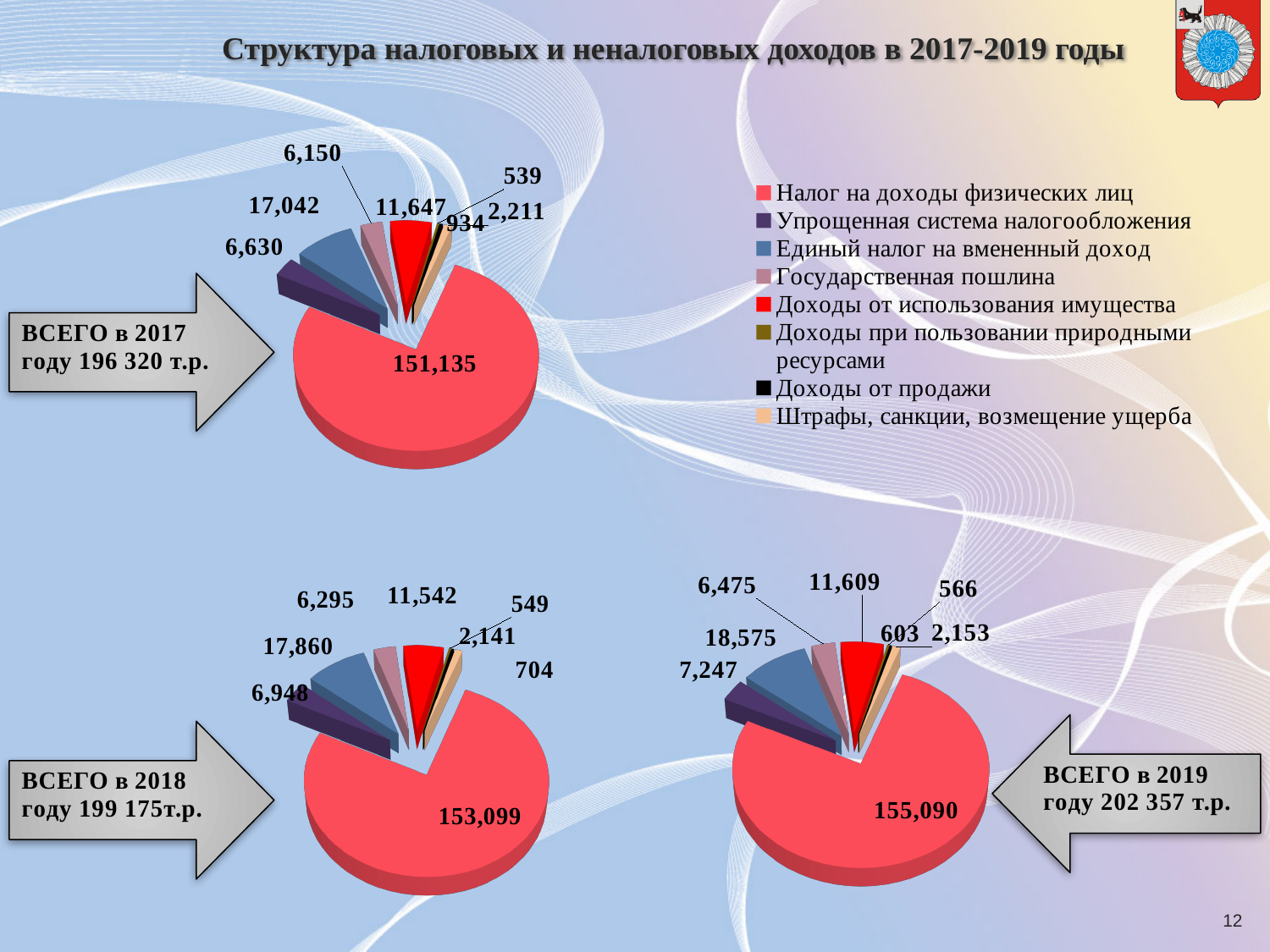
In the 2019 pie chart, what is the value for Доходы от использования имущества? 11,609 In the 2019 pie chart, which is larger: Государственная пошлина or Упрощенная система налогообложения? Упрощенная система налогообложения In the 2019 pie chart, what is the value for Упрощенная система налогообложения? 7,247 In the 2018 pie chart, what is the difference between Единый налог на вмененный доход (17,860) and Упрощенная система налогообложения (6,948)? 10,912 In the 2018 pie chart, which category has the largest value? Налог на доходы физических лиц What type of chart is used on this slide? Pie chart In the 2017 pie chart, what is the value of the largest slice (Налог на доходы физических лиц)? 151,135 In the 2017 pie chart, which category has the smallest value? Доходы при пользовании природными ресурсами In the 2018 pie chart, what is the value for Единый налог на вмененный доход? 17,860 What is the difference between the largest slice in the 2019 pie chart (155,090) and the largest slice in the 2017 pie chart (151,135)? 3,955 How many pie charts are shown on the slide? 3 How many categories does the legend list? 8